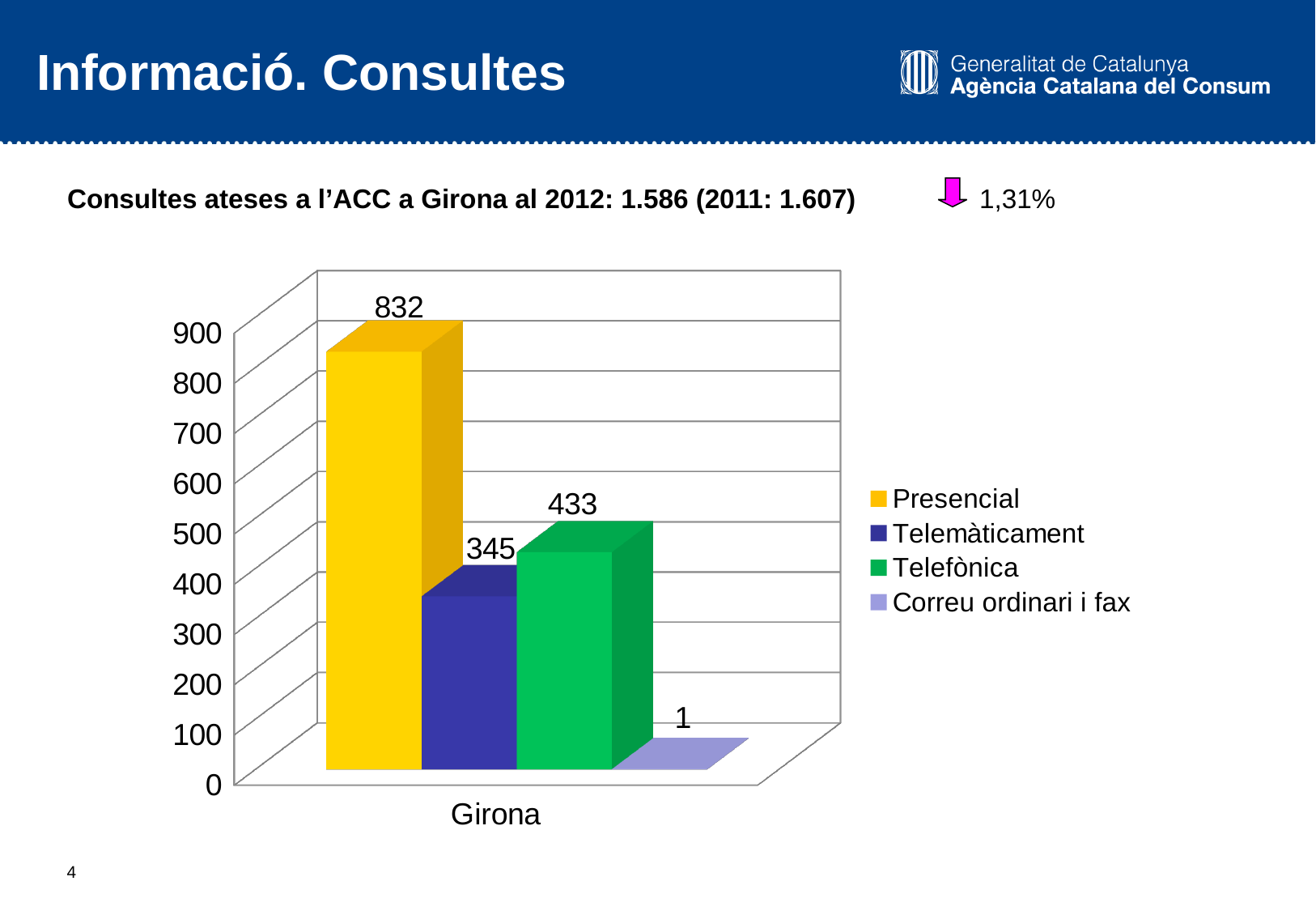
What kind of chart is shown on the slide? Bar chart What is the value for Presencial in the chart? 832 What colour is the Presencial bar in the chart? Yellow What is the difference between the Presencial and Telefònica values? 399 What is the value for Telemàticament in the chart? 345 Which series has the lowest value in the chart? Correu ordinari i fax What is the value for Correu ordinari i fax in the chart? 1 Which is larger, Telefònica or Telemàticament? Telefònica How many series does the legend list? 4 Which series has the highest value in the chart? Presencial What is the value for Telefònica in the chart? 433 What is the category label on the x axis of the chart? Girona